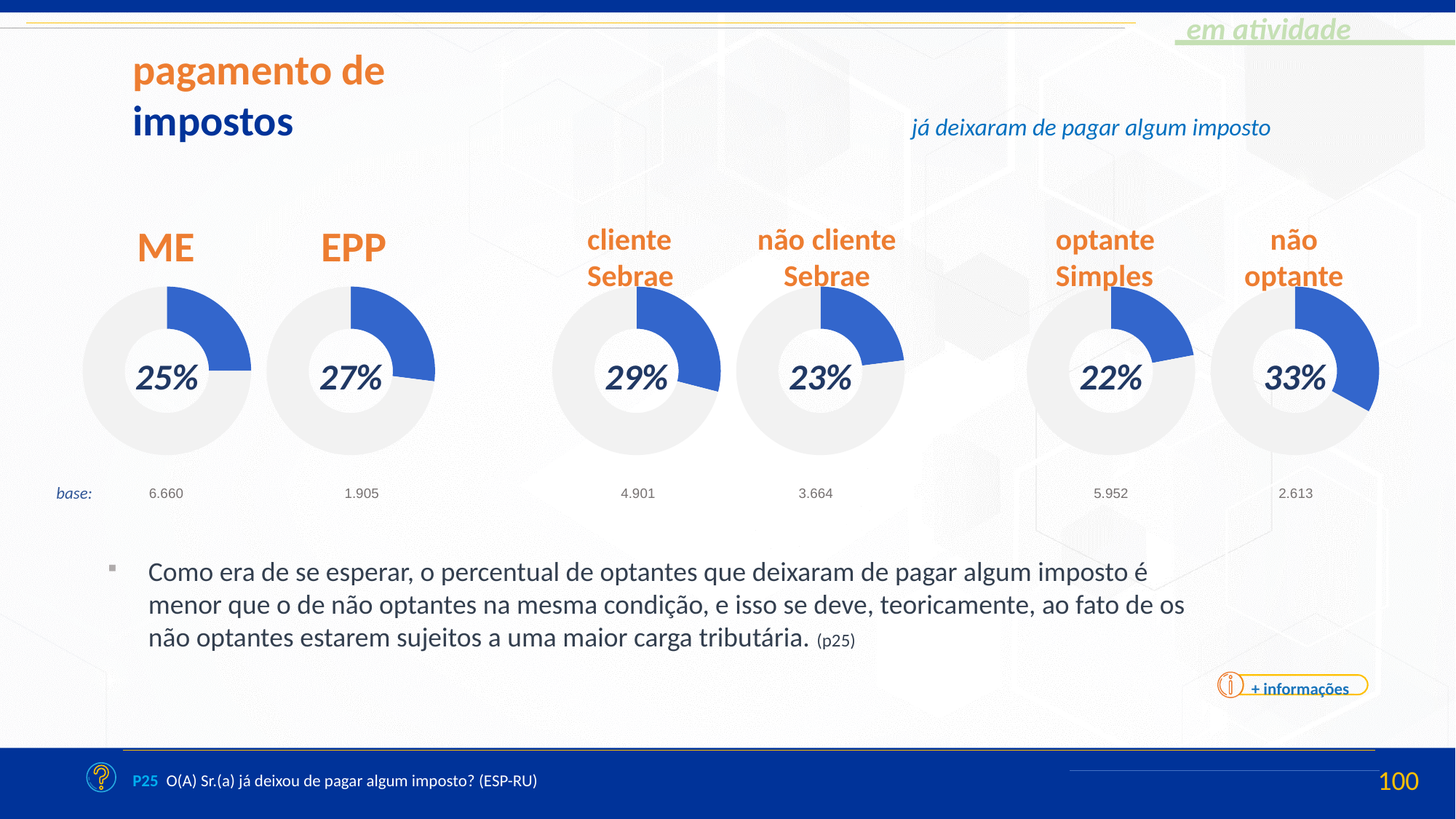
Across all six donut charts on the slide, which group has the highest percentage? não optante Which is larger, the percentage in the 'cliente Sebrae' chart or the 'não cliente Sebrae' chart? cliente Sebrae In the 'optante Simples' donut chart, what percentage is shown? 22% In the 'não optante' donut chart, what percentage is shown? 33% Across all six donut charts on the slide, which group has the lowest percentage? optante Simples In the ME donut chart, what percentage already stopped paying some tax? 25% What is the difference in percentage points between the 'não optante' chart and the 'optante Simples' chart? 11 In the EPP donut chart, what percentage is shown? 27% In the 'não cliente Sebrae' donut chart, what percentage is shown? 23% What type of chart is used to show the percentages on the slide? Donut (pie) chart In the 'cliente Sebrae' donut chart, what percentage is shown? 29% How many donut charts are shown on the slide? 6